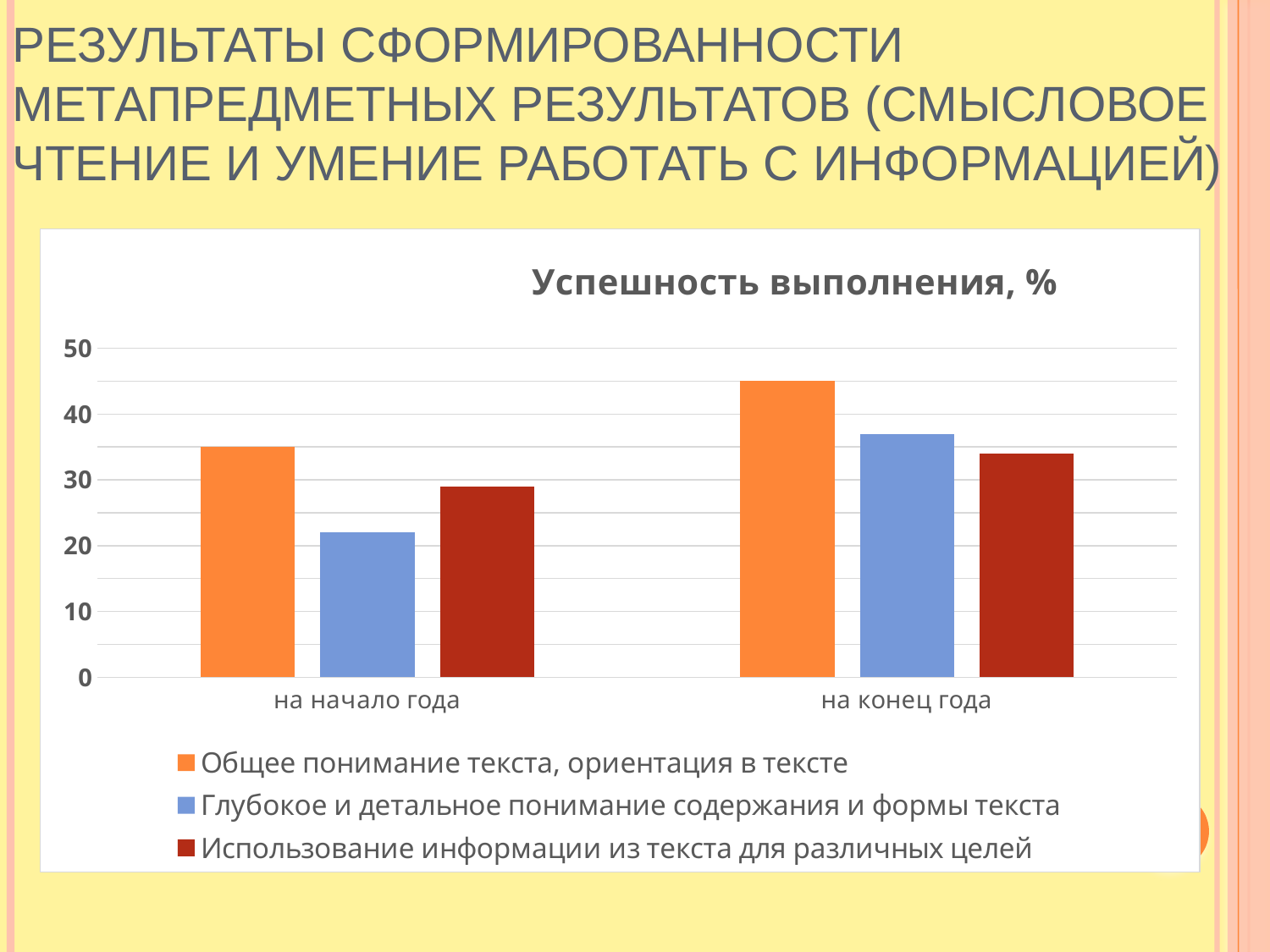
What is the title of the chart? Успешность выполнения, % Which series has the lowest value in the category 'на начало года'? Глубокое и детальное понимание содержания и формы текста Is the value for 'Глубокое и детальное понимание содержания и формы текста' in 'на начало года' greater or less than 30? less Which is larger: the value for 'Общее понимание текста, ориентация в тексте' in 'на начало года' or in 'на конец года'? на конец года How many categories are shown on the x axis? 2 How many series does the legend list? 3 Do the values for 'Глубокое и детальное понимание содержания и формы текста' rise or fall from 'на начало года' to 'на конец года'? rise Which colour represents the series 'Использование информации из текста для различных целей' in the legend? dark red Is the value for 'Общее понимание текста, ориентация в тексте' in 'на конец года' greater or less than 40? greater Is the value for 'Использование информации из текста для различных целей' in 'на начало года' greater or less than 20? greater What kind of chart is shown on the slide? bar chart Which series has the highest value in the category 'на конец года'? Общее понимание текста, ориентация в тексте